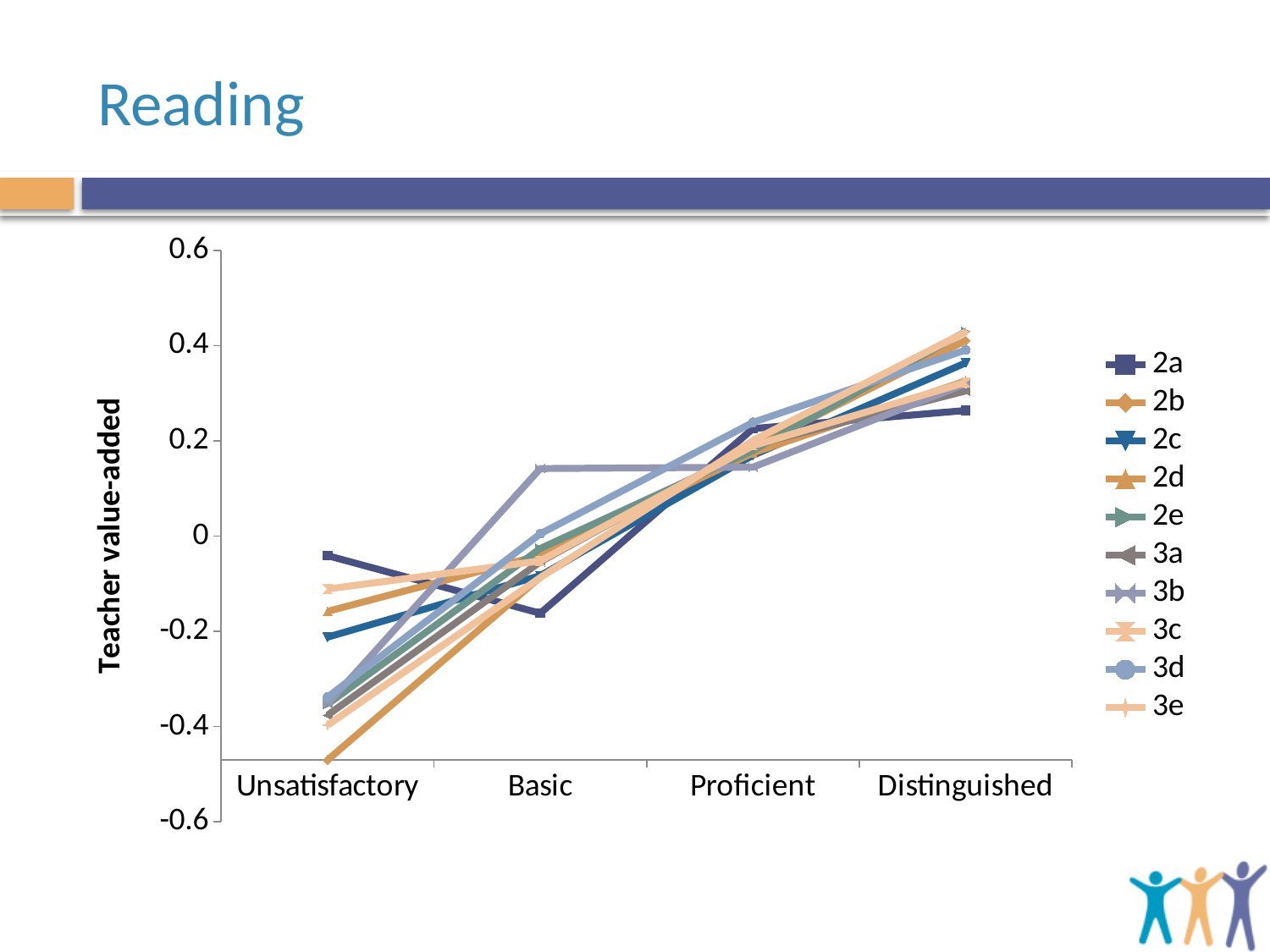
What is the title of the y axis? Teacher value-added How many series does the legend list? 10 Is the value for 2a at Distinguished greater or less than 0.4? less Is the value for 2b at Unsatisfactory greater or less than -0.4? less What is the title of the slide? Reading Which series has the highest value at Unsatisfactory? 2a Which series has the highest value at Basic? 3b Does the value for 2a rise or fall from Unsatisfactory to Basic? fall Which series has the lowest value at Unsatisfactory? 2b How many categories are shown on the x axis? 4 What kind of chart is shown on the slide? line chart At Distinguished, which is larger, 2a or 3b? 3b